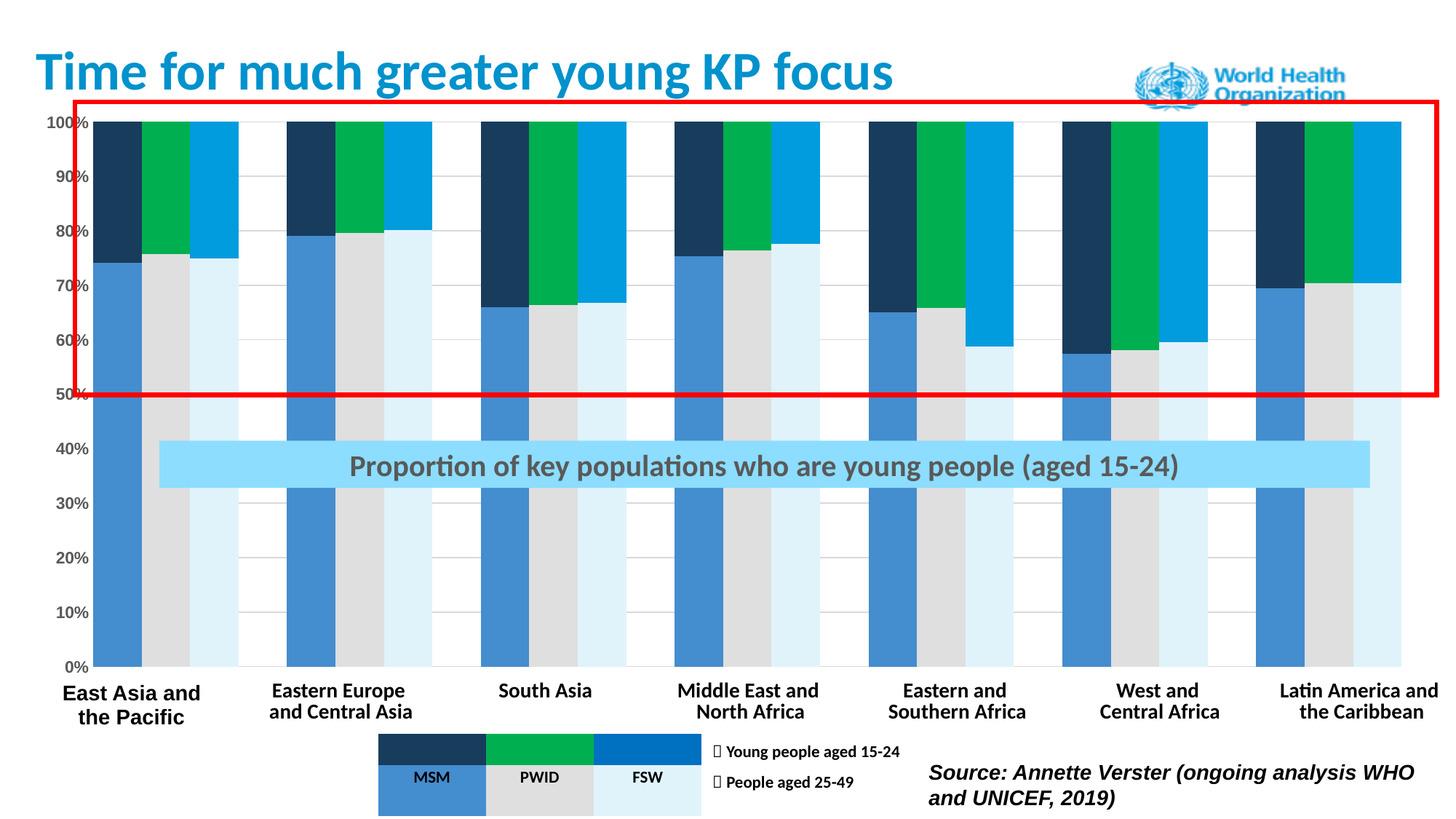
How many key population groups does the chart legend list? 3 Is the proportion of MSM aged 25-49 in South Asia greater or less than 70%? less Which key population groups are listed in the chart legend? MSM, PWID, FSW Is the proportion of FSW aged 25-49 in West and Central Africa greater or less than 70%? less Is the proportion of young people (aged 15-24) among FSW larger in Eastern and Southern Africa or in East Asia and the Pacific? Eastern and Southern Africa Which region has the largest proportion of young people (aged 15-24) among MSM? West and Central Africa What is the text of the banner label across the chart? Proportion of key populations who are young people (aged 15-24) Is the proportion of PWID aged 25-49 in Middle East and North Africa greater or less than 70%? greater What kind of chart is shown on the slide? Stacked bar chart How many regions are shown along the x axis of the chart? 7 Which region has the smallest proportion of young people (aged 15-24) among MSM? Eastern Europe and Central Asia